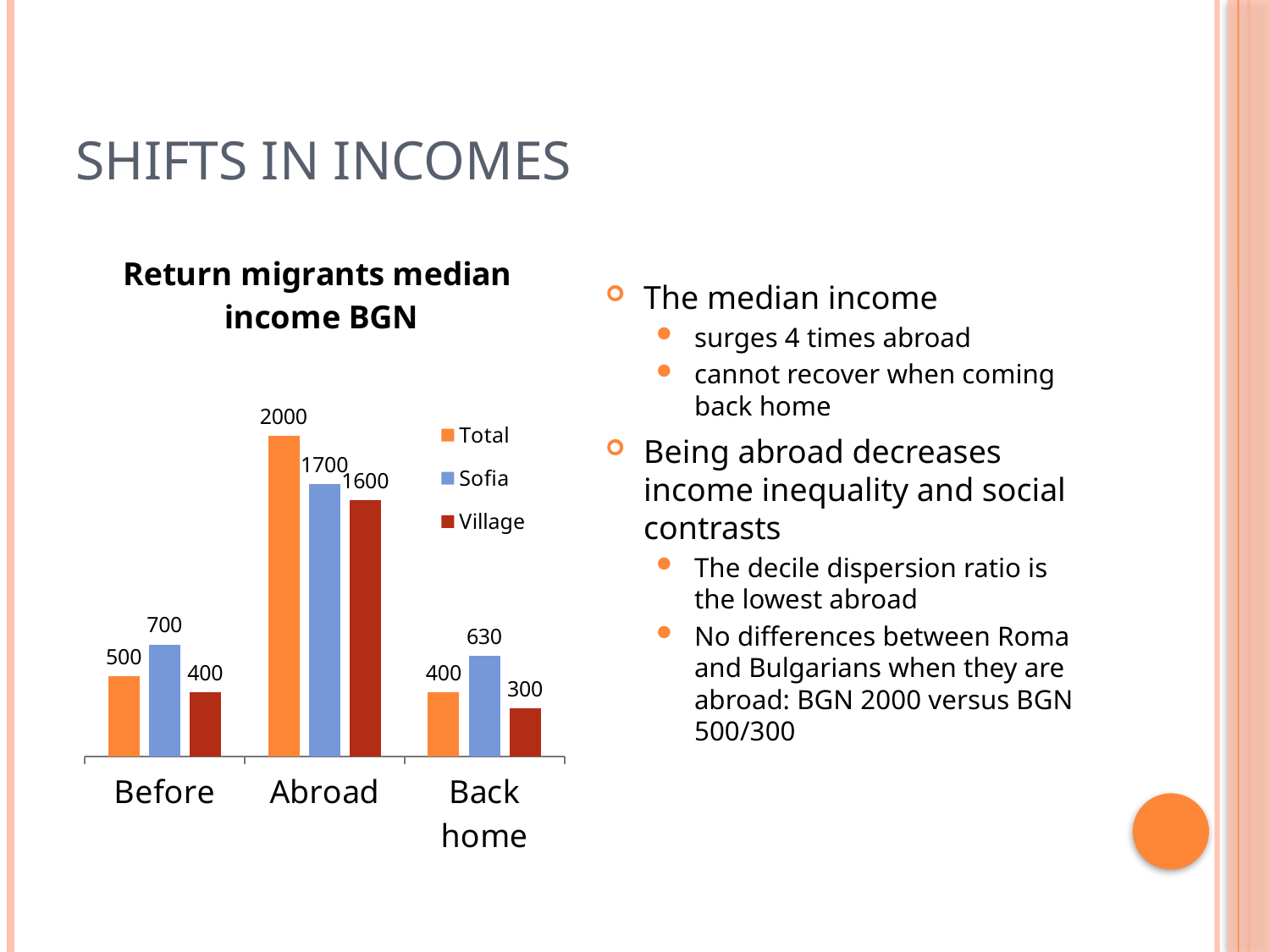
How many series does the legend list? 3 Which category has the highest Total median income? Abroad What is the Village value for the Back home category? 300 Which category has the lowest Village value? Back home What is the title of the chart? Return migrants median income BGN What kind of chart is shown on the slide? Bar chart What is the difference between the Sofia and Village values for the Abroad category? 100 Which is larger, the Sofia value for Back home or the Sofia value for Before? Before What is the difference between the Total value Abroad and the Total value Before? 1500 What is the Total median income for the Abroad category? 2000 What is the Sofia value for the Before category? 700 How many categories are shown on the x axis? 3